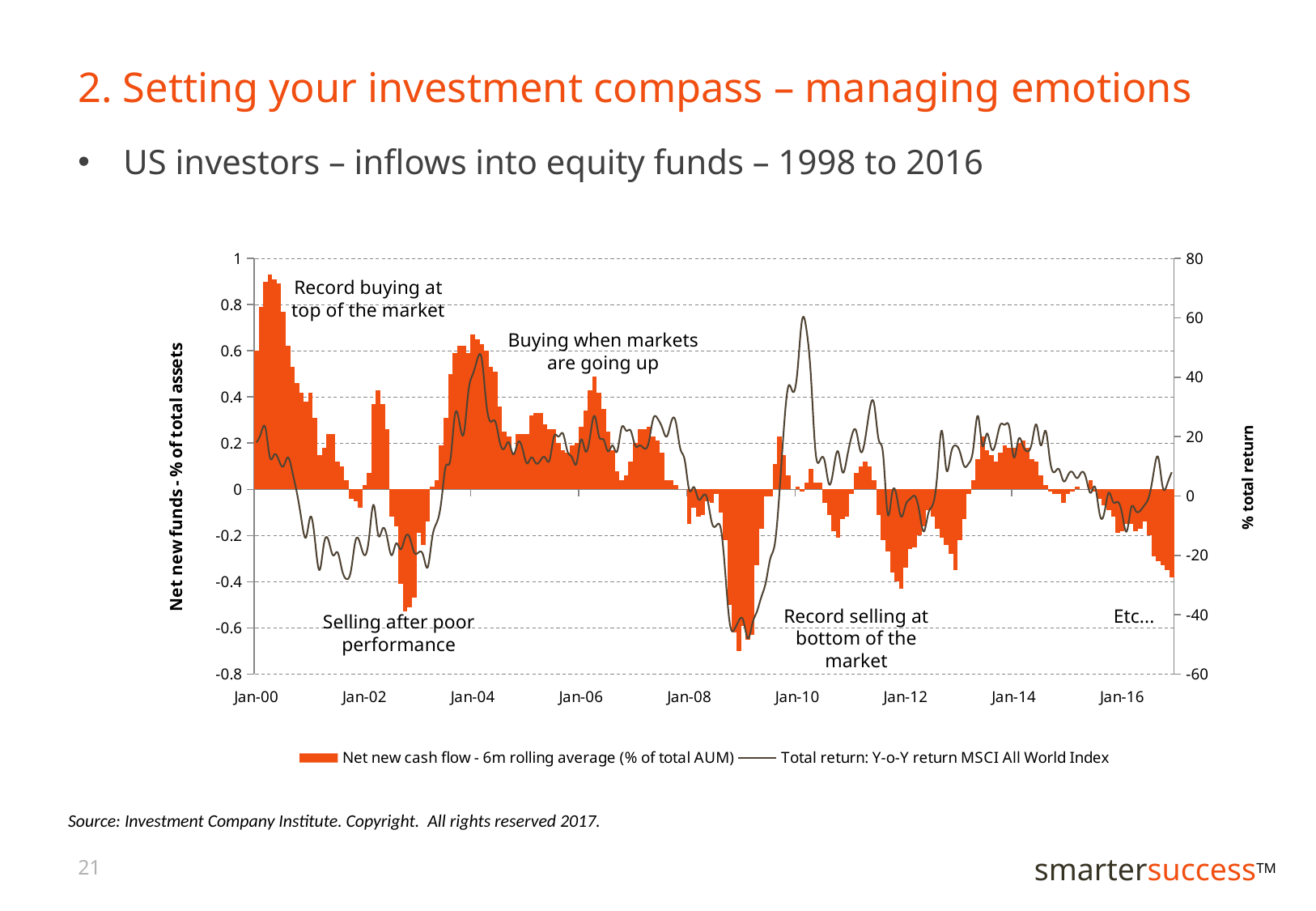
Is the peak value of net new cash flow in early 2000 greater or less than 0.8? greater What is the label of the right-hand vertical axis? % total return Around which year does the net new cash flow bar series reach its lowest value? 2008 (around Dec-08) Is the lowest point of the total return line in 2008-2009 greater or less than -40? less How many series does the chart legend list? 2 Is the peak of the total return line in 2010 greater or less than 40? greater Around which year does the net new cash flow bar series reach its highest value? 2000 (around Jan-00) Which is larger: the peak of net new cash flow in 2000 or the peak in 2004? The peak in 2000 What kind of chart is shown on the slide? A combined bar and line chart How many year labels are shown on the x axis? 9 Which series is drawn as orange bars according to the legend? Net new cash flow - 6m rolling average (% of total AUM)